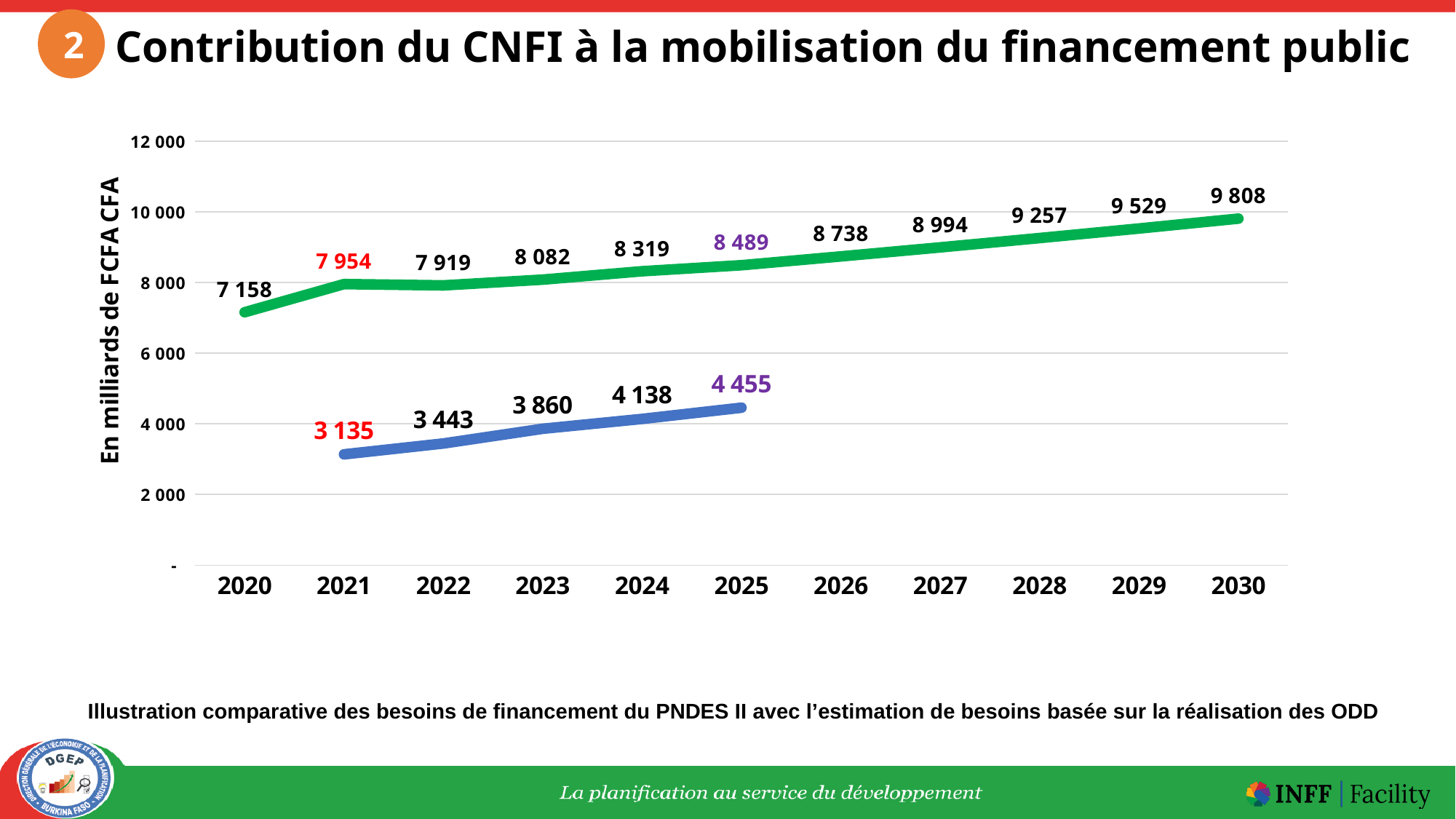
What is the value of the green line in 2030? 9 808 What is the value of the blue line in 2021? 3 135 What type of chart is shown on the slide? Line chart What is the value of the green line in 2020? 7 158 Does the blue line rise or fall from 2021 to 2025? Rise Which is larger: the green line value in 2021 or in 2022? 2021 How many years are shown on the x axis? 11 What is the value of the blue line in 2025? 4 455 What is the label of the vertical axis? En milliards de FCFA CFA In which year does the green line have its lowest value? 2020 What is the difference between the green line and the blue line in 2025? 4 034 In which year does the green line reach its highest value? 2030